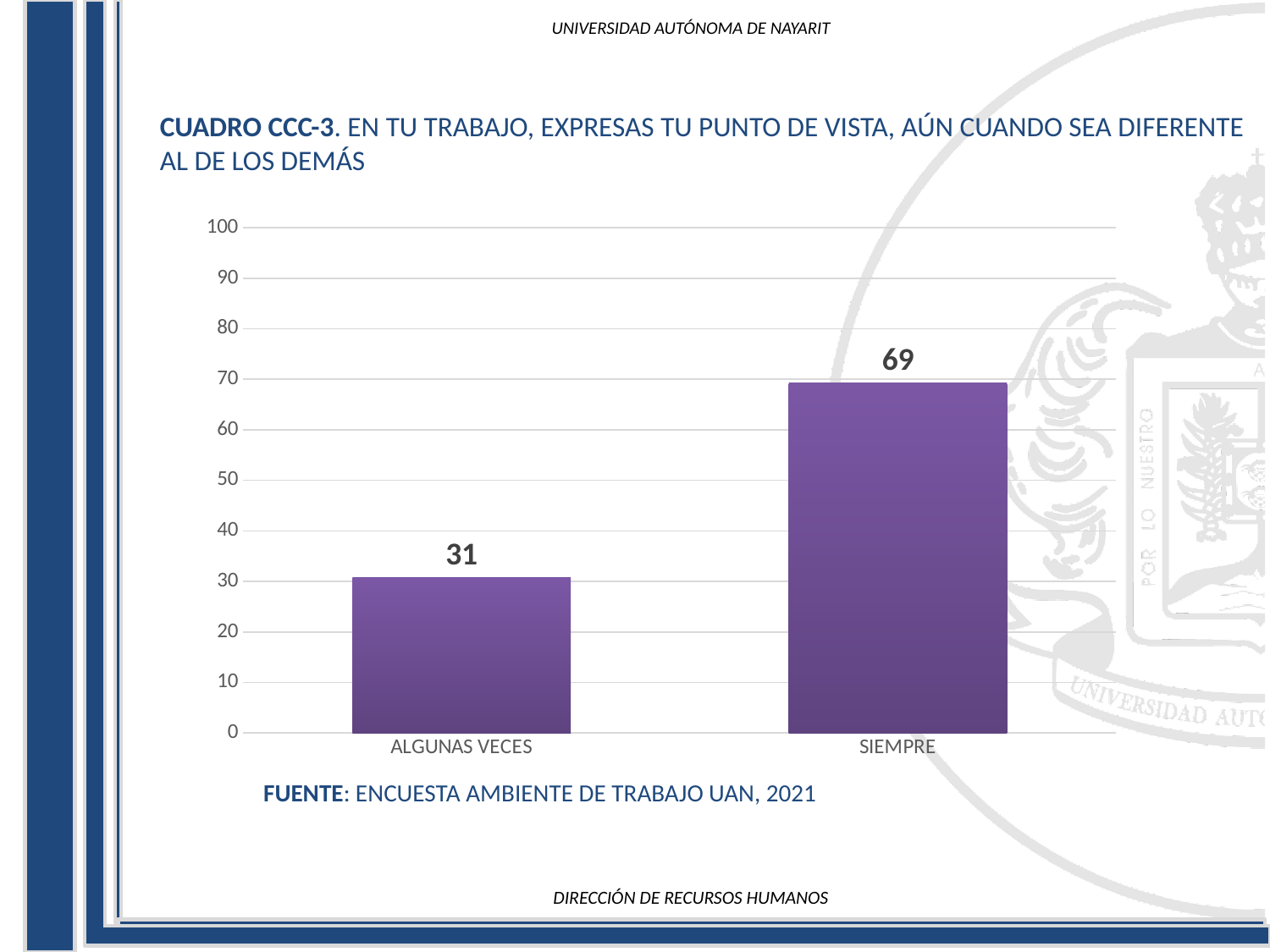
What is the value for ALGUNAS VECES? 31 Which category has the highest value? SIEMPRE What source is cited below the chart? ENCUESTA AMBIENTE DE TRABAJO UAN, 2021 Is the value for SIEMPRE greater or less than 60? greater Is the value for ALGUNAS VECES greater or less than 40? less What is the total of the two bar values? 100 Which is larger, the value for ALGUNAS VECES or the value for SIEMPRE? SIEMPRE What is the value for SIEMPRE? 69 How many categories are shown on the x axis? 2 Which category has the lowest value? ALGUNAS VECES What is the difference between the values for SIEMPRE and ALGUNAS VECES? 38 What kind of chart is shown on the slide? bar chart